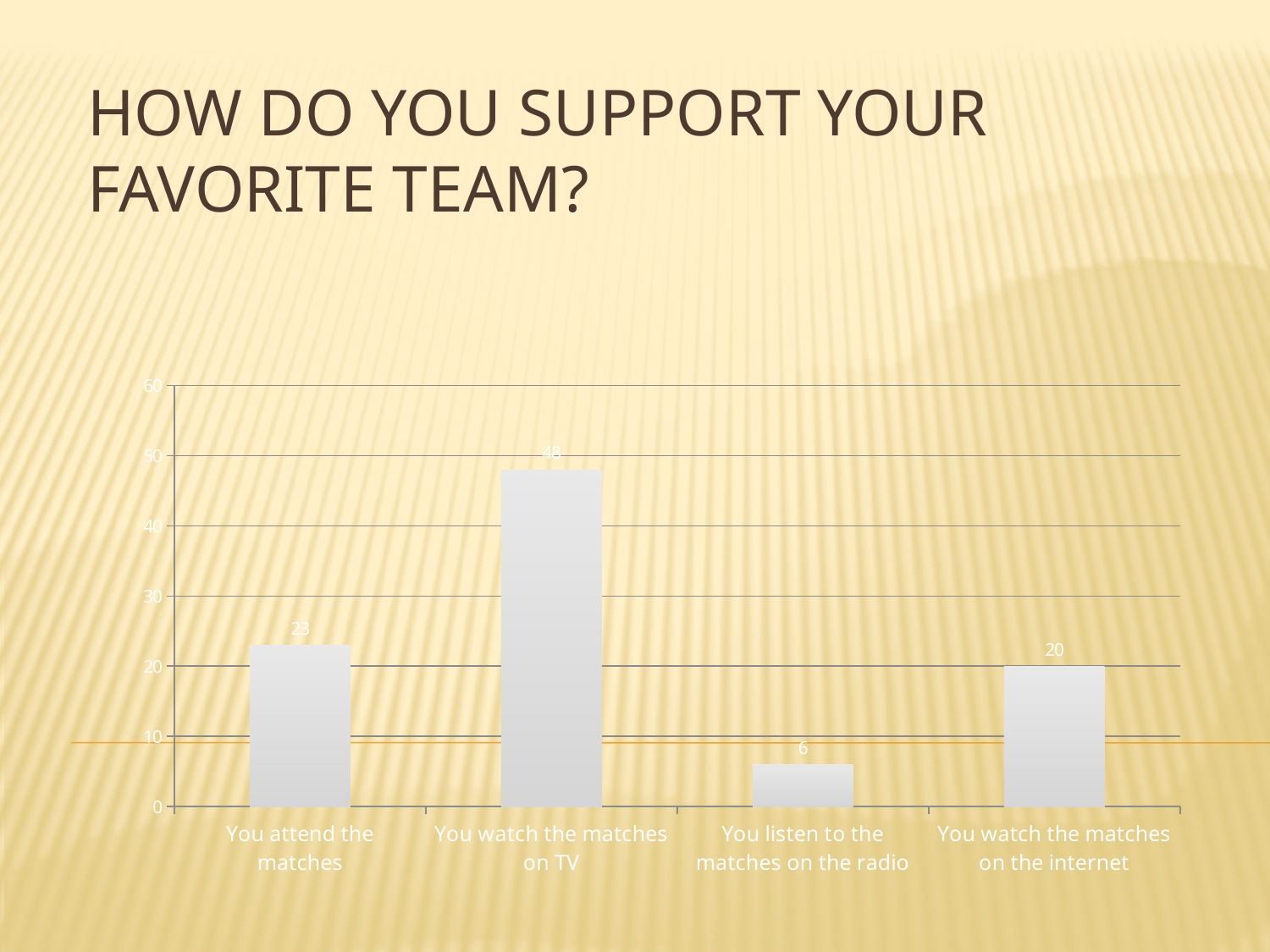
Which category has the lowest value? You listen to the matches on the radio How many categories are shown on the x axis? 4 What kind of chart is shown on the slide? bar chart What is the value for 'You attend the matches'? 23 Which is larger: the value for 'You attend the matches' or 'You watch the matches on the internet'? You attend the matches What is the difference between the values for 'You watch the matches on TV' and 'You attend the matches'? 25 Is the value for 'You listen to the matches on the radio' greater or less than 10? less What is the title of the slide containing the chart? How do you support your favorite team? What is the value for 'You watch the matches on TV'? 48 Which category has the highest value? You watch the matches on TV What is the value for 'You watch the matches on the internet'? 20 What is the value for 'You listen to the matches on the radio'? 6